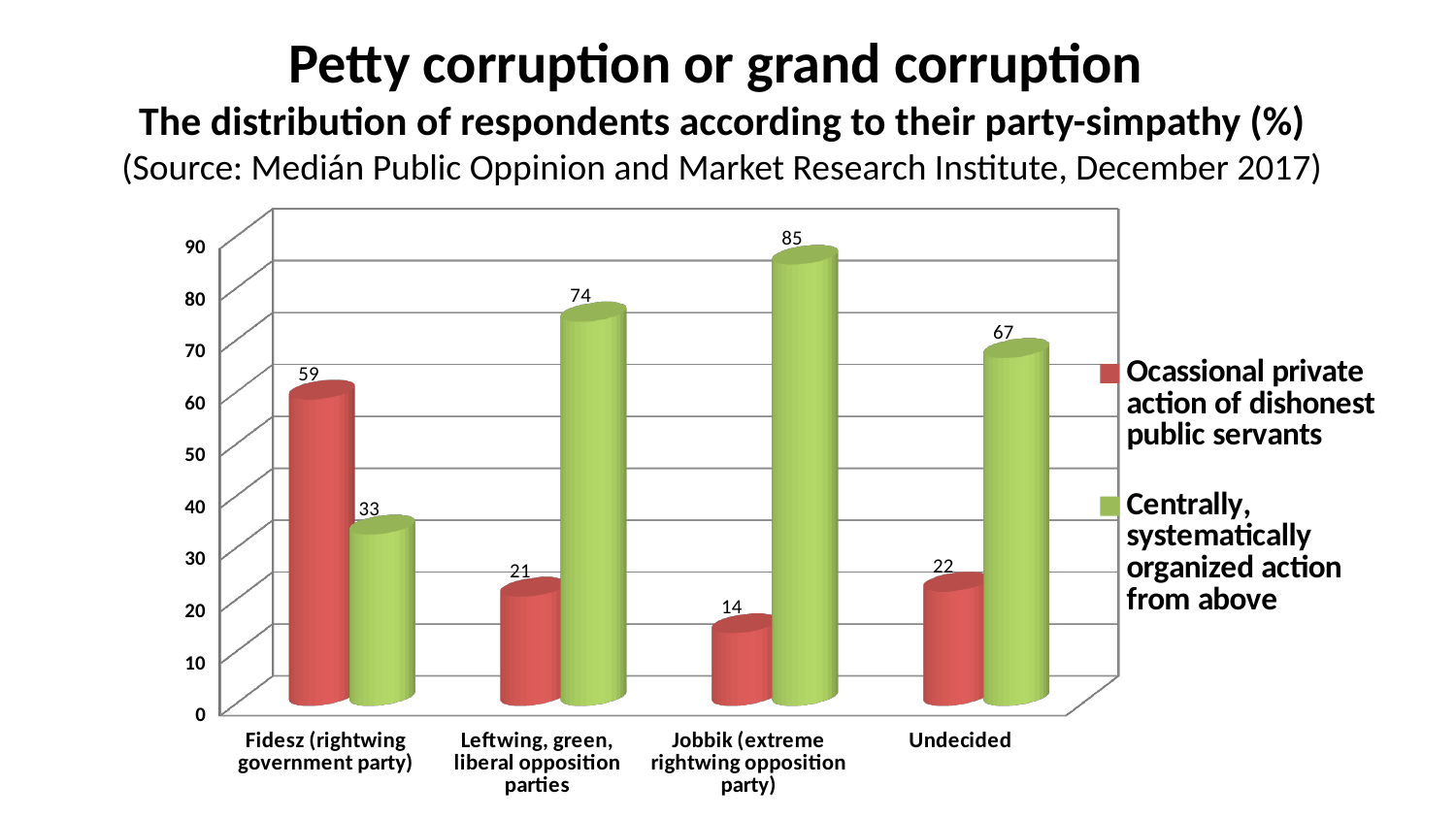
Which colour represents 'Centrally, systematically organized action from above' in the legend? Green What kind of chart is shown on the slide? Bar chart Which category has the highest value for 'Centrally, systematically organized action from above'? Jobbik (extreme rightwing opposition party) What is the value for 'Ocassional private action of dishonest public servants' for Fidesz (rightwing government party)? 59 For Fidesz (rightwing government party), which series has the larger value? Ocassional private action of dishonest public servants How many series does the legend list? 2 What is the difference between the two series' values for Leftwing, green, liberal opposition parties? 53 Is the value for 'Centrally, systematically organized action from above' for Undecided greater or less than 60? greater What is the value for 'Centrally, systematically organized action from above' for Jobbik (extreme rightwing opposition party)? 85 How many categories are shown on the x axis? 4 What is the value for 'Centrally, systematically organized action from above' for Undecided? 67 Which category has the lowest value for 'Ocassional private action of dishonest public servants'? Jobbik (extreme rightwing opposition party)